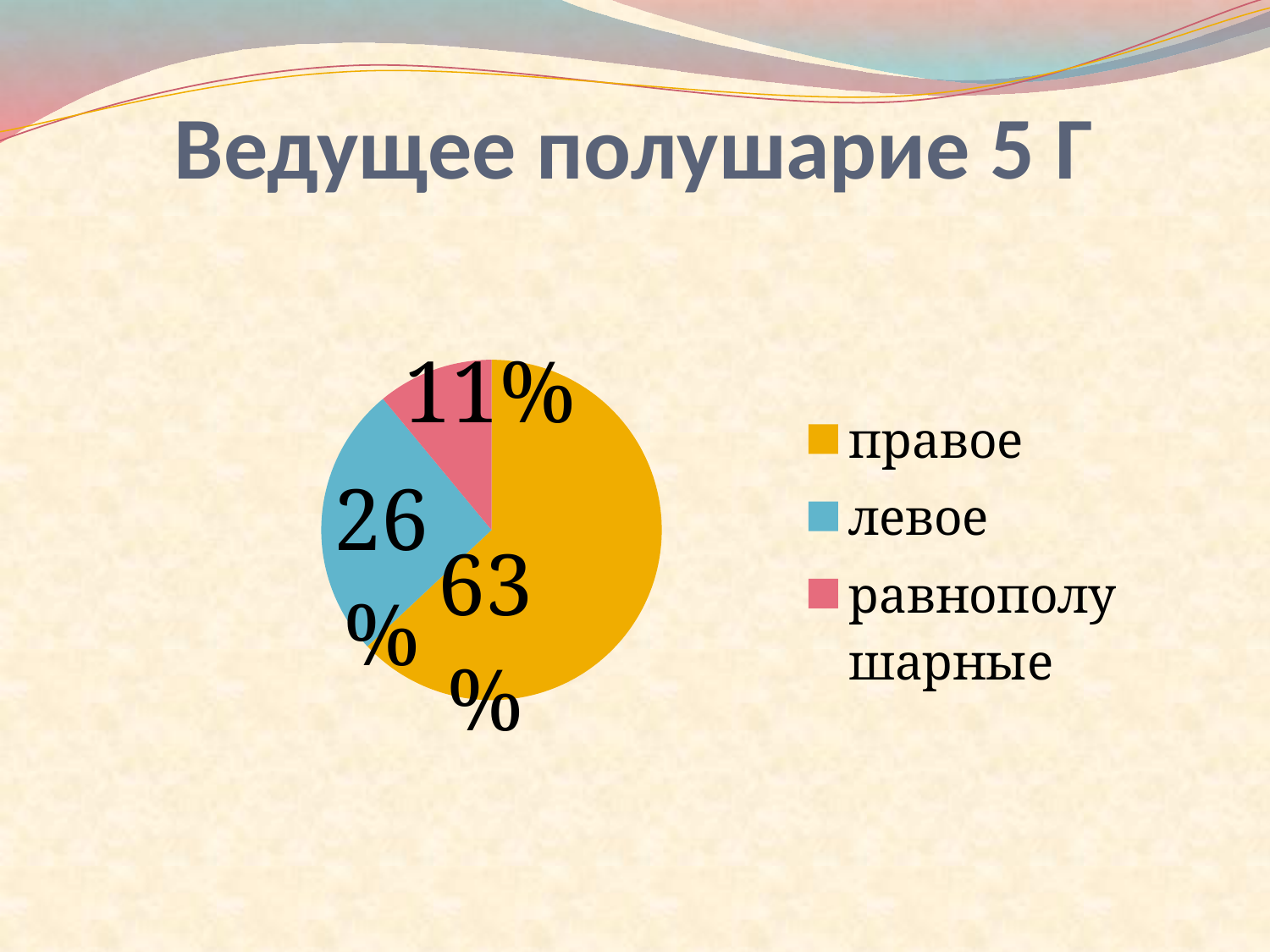
What percentage is shown for равнополушарные? 11% What percentage is shown for правое? 63% How many categories does the pie chart have? 3 Which is larger, the slice for левое or the slice for равнополушарные? левое What percentage is shown for левое? 26% What is the difference between the percentages for правое and левое? 37% What is the title of the slide containing the chart? Ведущее полушарие 5 Г What kind of chart is shown on the slide? pie chart Which category has the smallest slice of the pie? равнополушарные What is the difference between the percentages for левое and равнополушарные? 15% Which category has the largest slice of the pie? правое What colour is the slice for левое? blue